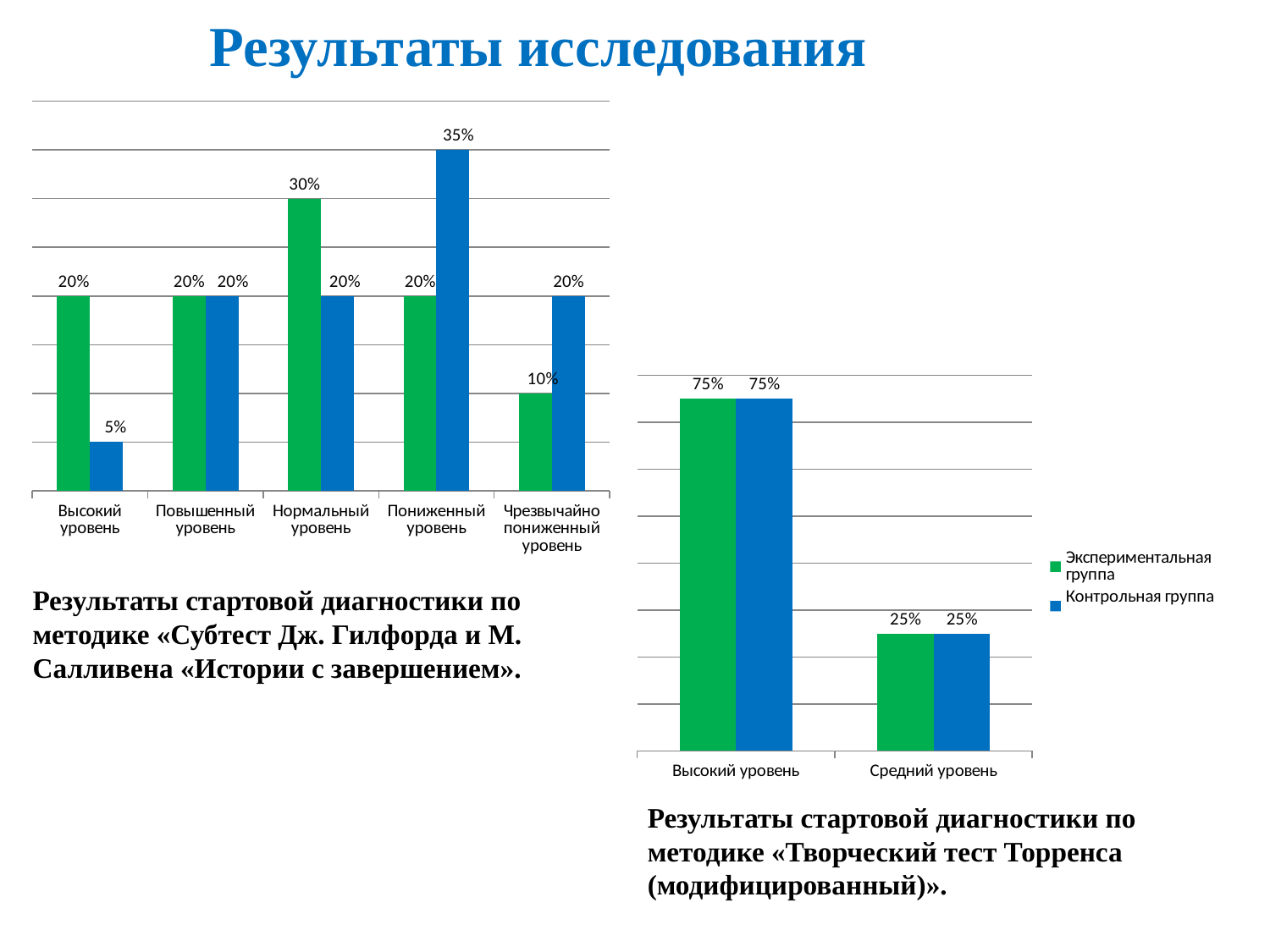
On the left chart (Субтест Дж. Гилфорда и М. Салливена), which category has the highest blue bar? Пониженный уровень On the left chart (Субтест Дж. Гилфорда и М. Салливена), which category has the lowest green bar? Чрезвычайно пониженный уровень On the left chart (Субтест Дж. Гилфорда и М. Салливена), what is the value of the blue bar for Высокий уровень? 5% How many series does the legend of the right chart (Творческий тест Торренса) list? 2 How many categories are shown on the left chart (Субтест Дж. Гилфорда и М. Салливена)? 5 On the left chart (Субтест Дж. Гилфорда и М. Салливена), what is the value of the green bar for Нормальный уровень? 30% On the left chart (Субтест Дж. Гилфорда и М. Салливена), what is the value of the blue bar for Пониженный уровень? 35% On the left chart (Субтест Дж. Гилфорда и М. Салливена), which is larger for Чрезвычайно пониженный уровень: the green bar or the blue bar? the blue bar On the left chart (Субтест Дж. Гилфорда и М. Салливена), what is the difference between the green and blue bars for Высокий уровень? 15% On the right chart (Творческий тест Торренса), what is the value for Экспериментальная группа at Средний уровень? 25% On the right chart (Творческий тест Торренса), what is the value for Контрольная группа at Высокий уровень? 75% What type of chart is the right chart (Творческий тест Торренса)? bar chart